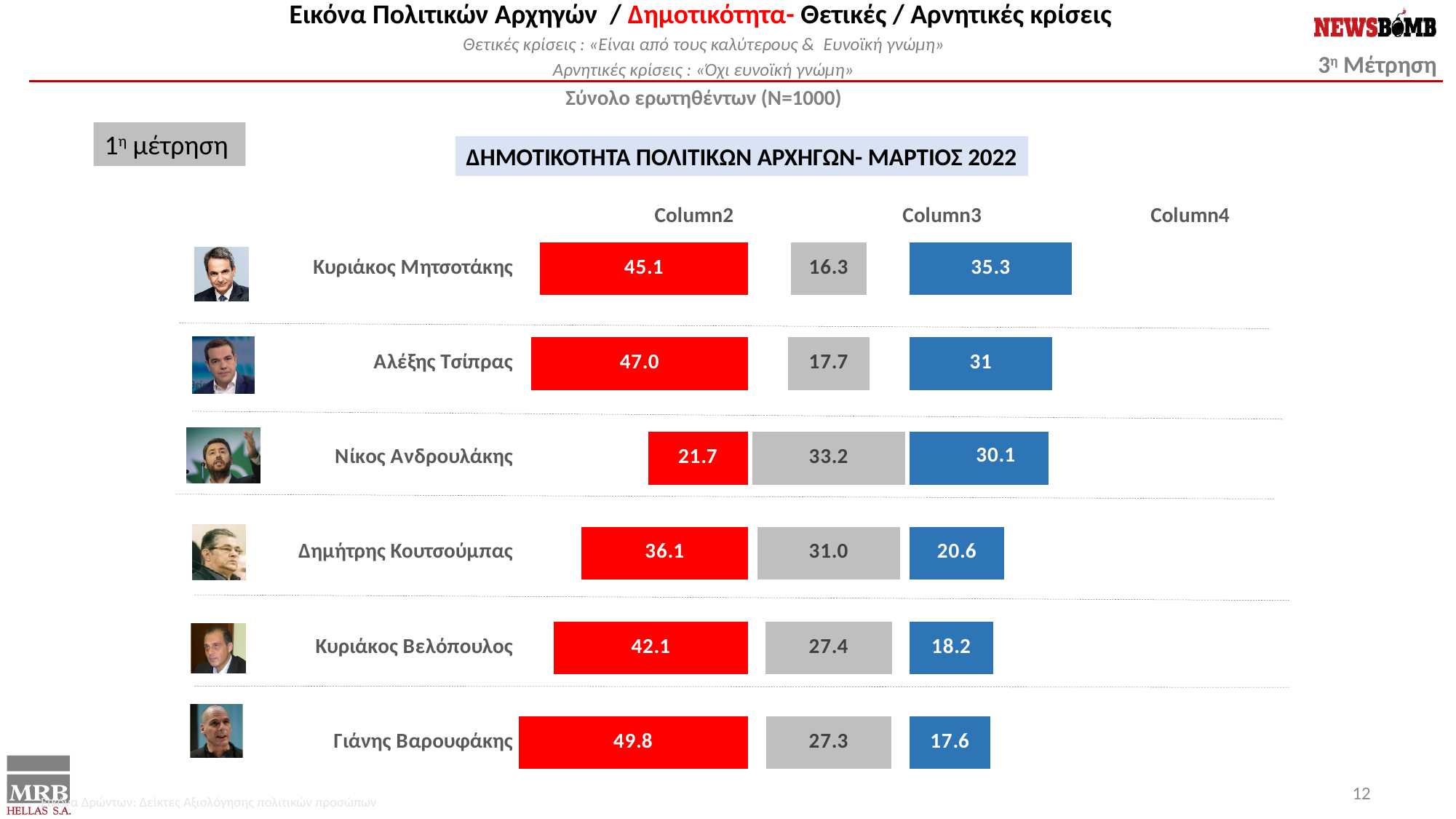
What is the difference between the Column2 values of Γιάνης Βαρουφάκης and Νίκος Ανδρουλάκης? 28.1 How many series does the chart show? 3 Which politician has the highest Column2 value? Γιάνης Βαρουφάκης What is the Column2 value for Κυριάκος Μητσοτάκης? 45.1 Who has the larger Column2 value, Δημήτρης Κουτσούμπας or Κυριάκος Βελόπουλος? Κυριάκος Βελόπουλος How many politicians are shown in the chart? 6 Which politician has the lowest Column2 value? Νίκος Ανδρουλάκης Which politician has the highest Column4 value? Κυριάκος Μητσοτάκης Which politician has the lowest Column3 value? Κυριάκος Μητσοτάκης What is the Column4 value for Γιάνης Βαρουφάκης? 17.6 What is the Column3 value for Νίκος Ανδρουλάκης? 33.2 What is the Column4 value for Αλέξης Τσίπρας? 31